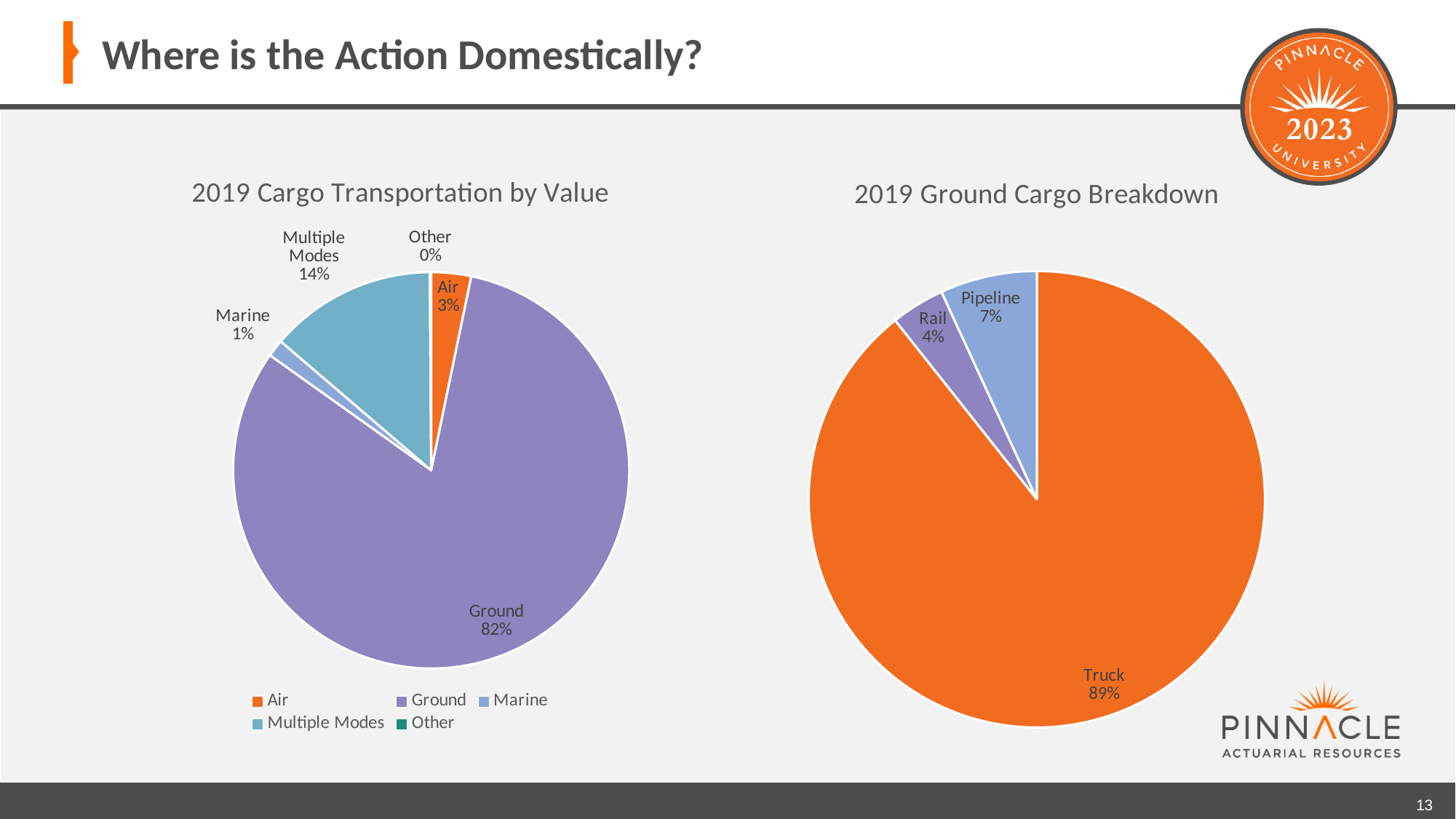
In the '2019 Cargo Transportation by Value' chart, which category has the largest share? Ground In the '2019 Ground Cargo Breakdown' chart, what share does Rail have? 4% In the '2019 Cargo Transportation by Value' chart, what is the difference in percentage points between Ground and Multiple Modes? 68 In the '2019 Ground Cargo Breakdown' chart, which category has the smallest share? Rail In the '2019 Ground Cargo Breakdown' chart, what is the difference in percentage points between Pipeline and Rail? 3 In the '2019 Cargo Transportation by Value' chart, what share does Multiple Modes have? 14% In the '2019 Cargo Transportation by Value' chart, what share does Ground have? 82% In the '2019 Cargo Transportation by Value' chart, which is larger, Air or Marine? Air How many categories does the legend of the '2019 Cargo Transportation by Value' chart list? 5 In the '2019 Ground Cargo Breakdown' chart, what share does Truck have? 89% How many slices are shown in the '2019 Ground Cargo Breakdown' chart? 3 What kind of chart is '2019 Cargo Transportation by Value'? Pie chart